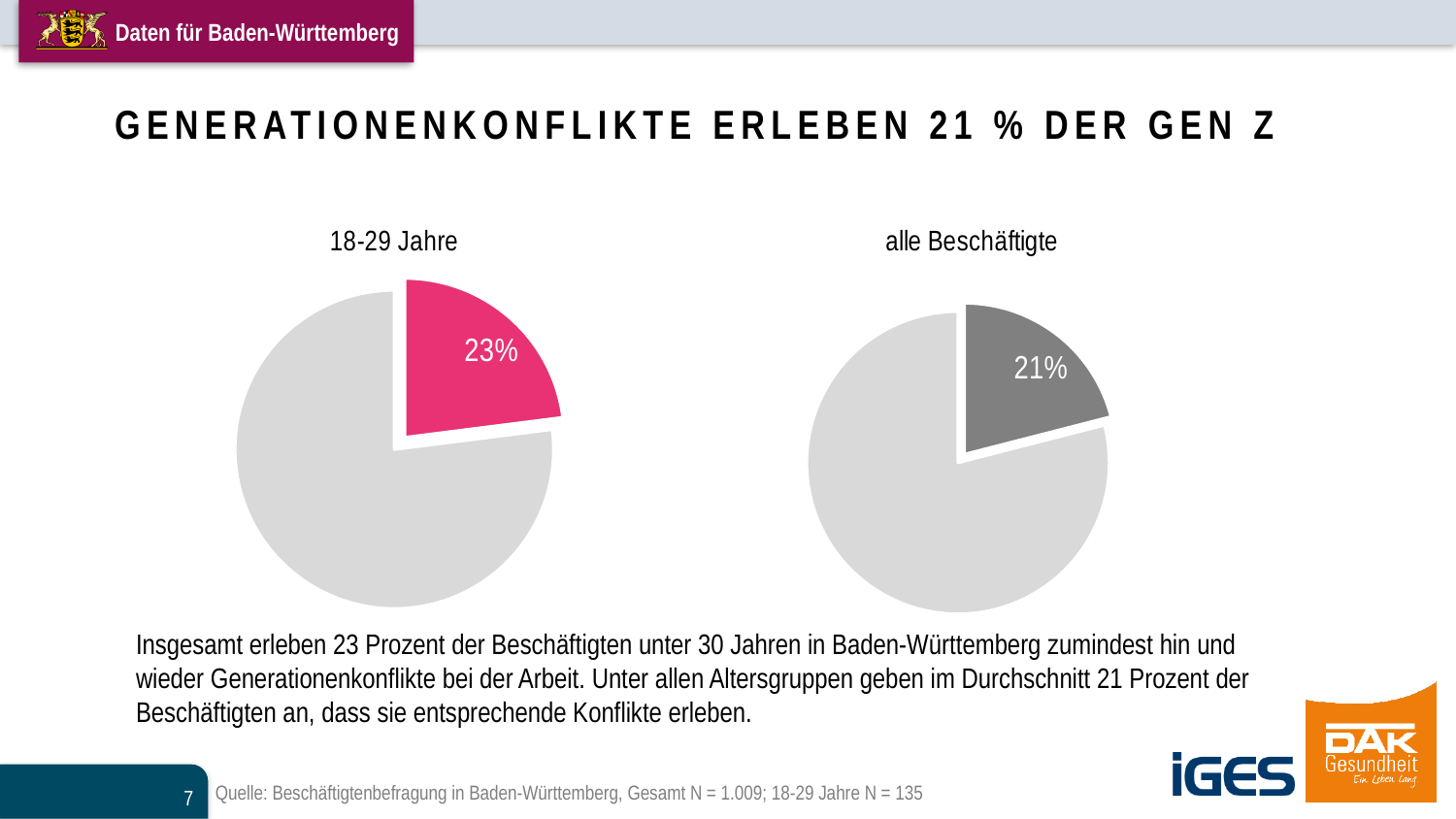
What kind of chart is the 'alle Beschäftigte' chart? Pie chart What colour is the highlighted slice in the '18-29 Jahre' pie chart? Pink In the '18-29 Jahre' pie chart, what share is shown for the highlighted slice? 23% What is the title of the pie chart on the left? 18-29 Jahre What is the difference in percentage points between the labelled slice in the '18-29 Jahre' chart and the labelled slice in the 'alle Beschäftigte' chart? 2 percentage points In the '18-29 Jahre' pie chart, is the labelled slice greater or less than 25%? less Which chart shows the larger labelled slice, '18-29 Jahre' or 'alle Beschäftigte'? 18-29 Jahre How many pie charts are shown on the slide? 2 In the 'alle Beschäftigte' pie chart, is the labelled slice greater or less than 20%? greater What kind of chart is the '18-29 Jahre' chart? Pie chart In the 'alle Beschäftigte' pie chart, what share is shown for the highlighted slice? 21%